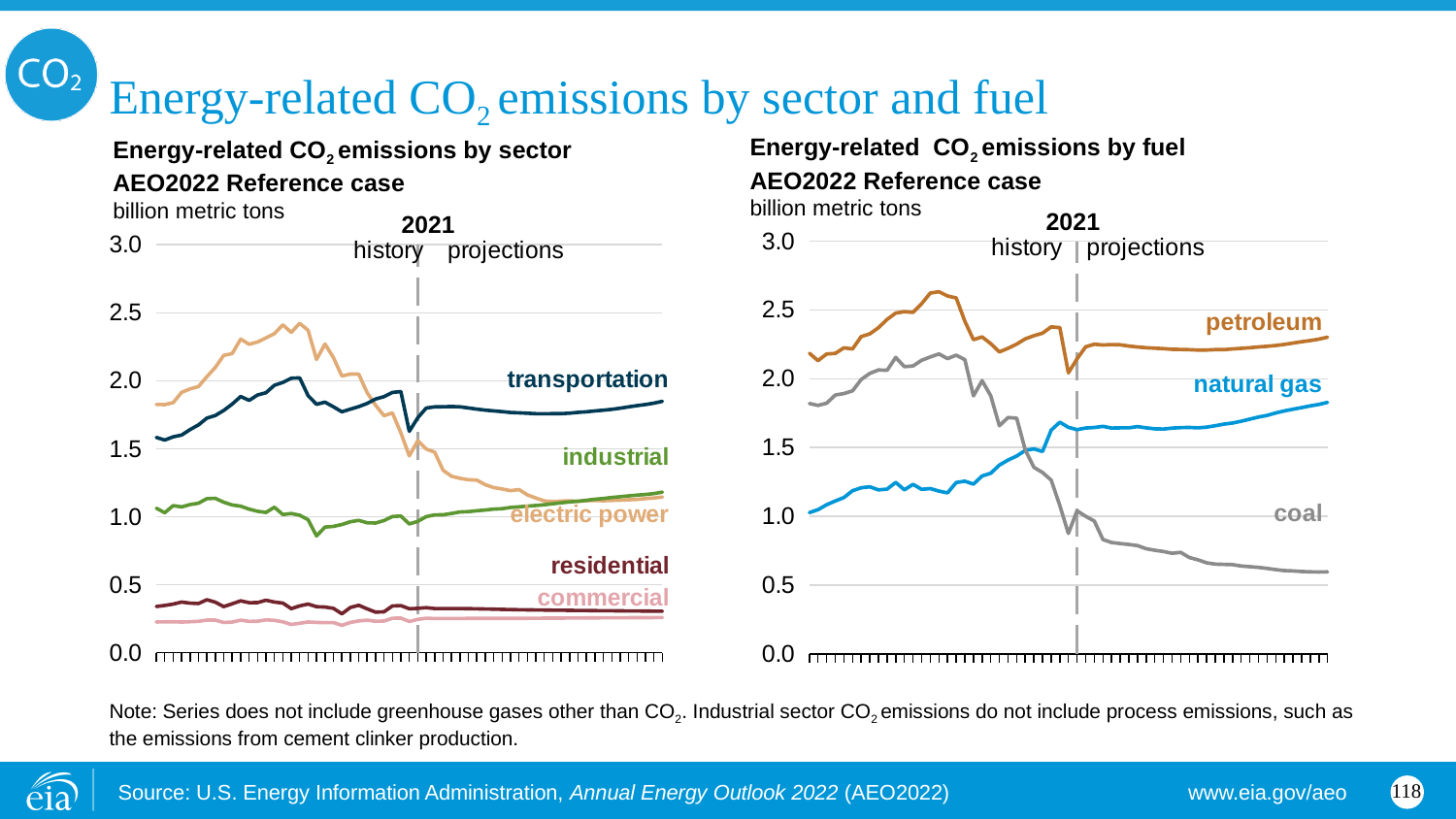
What kind of chart is the 'Energy-related CO2 emissions by sector' chart on the left? line chart How many sector series are plotted in the left chart, 'Energy-related CO2 emissions by sector'? 5 In the right chart (by fuel), is the value for coal at the end of the projection period greater or less than 1.0? less How many fuel series are plotted in the right chart, 'Energy-related CO2 emissions by fuel'? 3 What unit is used on the y axis of both charts? billion metric tons In the left chart (by sector), at the end of the projection period, which is larger: transportation or industrial? transportation In the right chart (by fuel), does the natural gas series rise or fall over the projection period? rise In the right chart (by fuel), which fuel has the lowest emissions at the end of the projection period? coal In the left chart (by sector), which sector has the highest emissions at the end of the projection period? transportation In the right chart (by fuel), is the value for petroleum at the end of the projection period greater or less than 2.0? greater In the right chart (by fuel), does the coal series rise or fall over the projection period? fall In the left chart (by sector), is the value for residential at the end of the projection period greater or less than 0.5? less